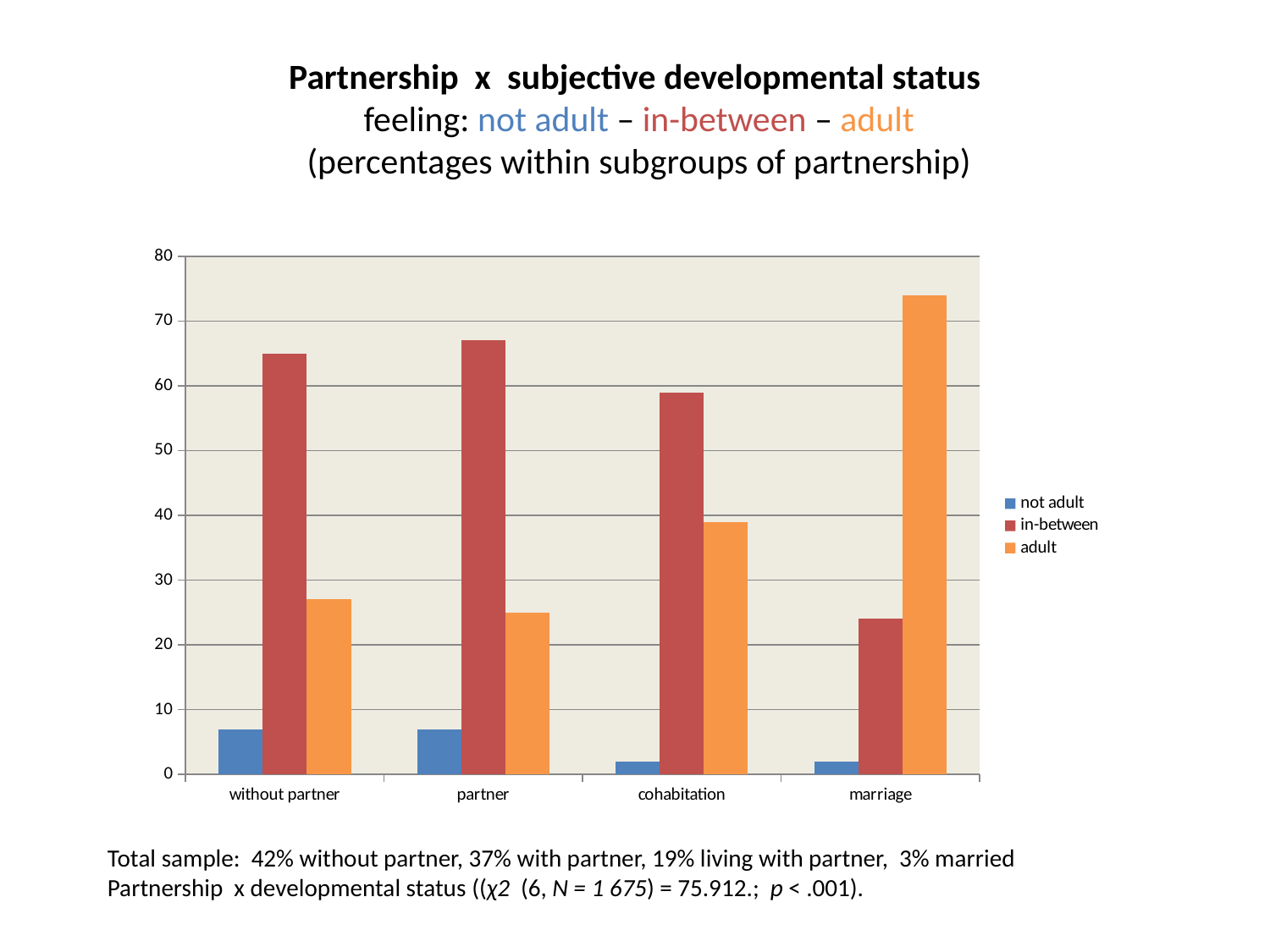
What kind of chart is shown on the slide? bar chart Which partnership category has the lowest value for the in-between series? marriage Which partnership category has the highest value for the adult series? marriage Does the adult series rise or fall moving from without partner to marriage along the x axis? rise Is the value for adult in the cohabitation category greater or less than 30? greater Is the value for in-between in the without partner category greater or less than 60? greater Is the value for not adult in the cohabitation category greater or less than 10? less How many series does the legend list? 3 Which is larger in the partner category: the in-between value or the adult value? in-between How many partnership categories are shown on the x axis? 4 Which colour represents the in-between series in the legend? red